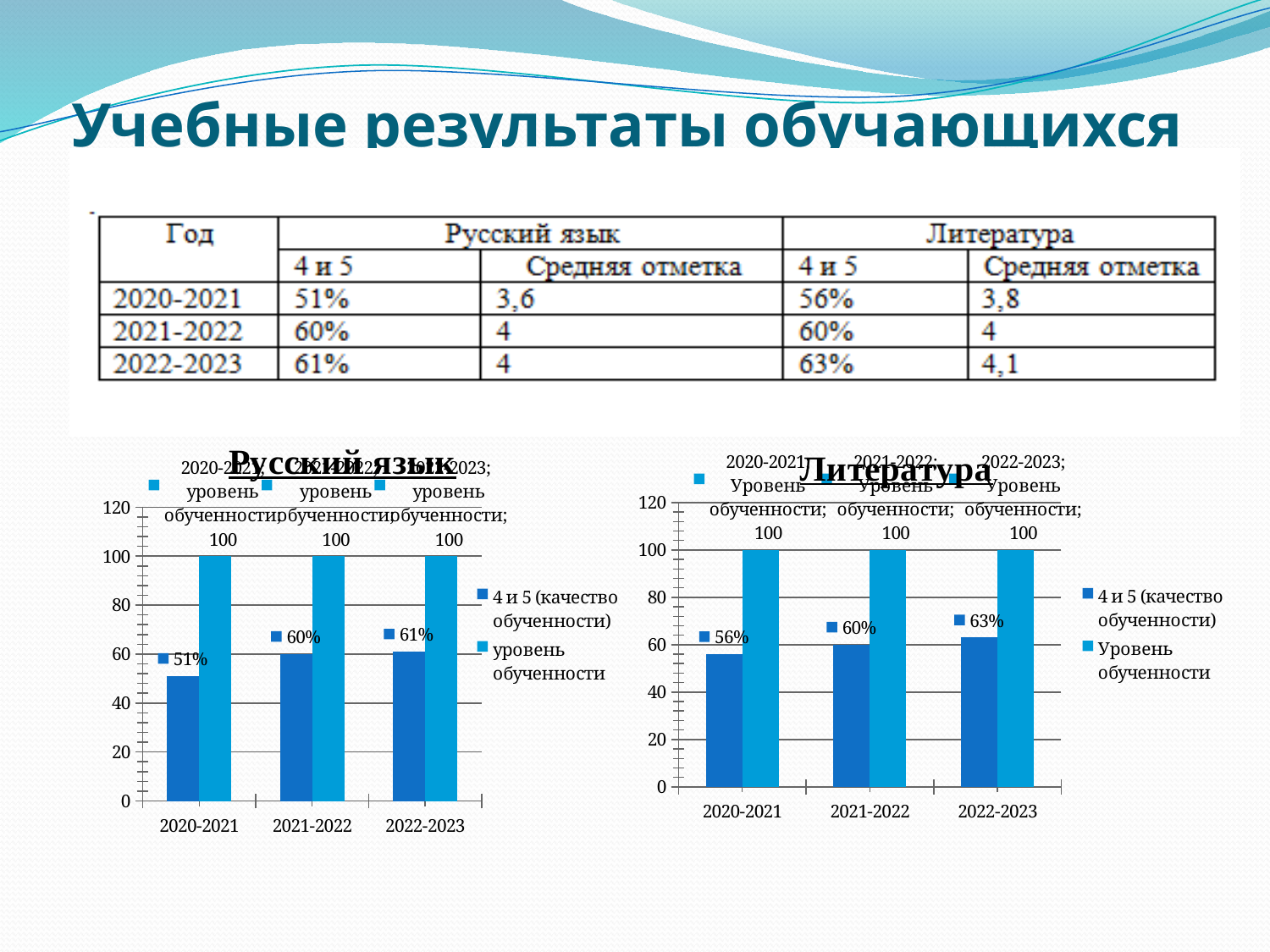
In the 'Русский язык' chart, what is the difference between the '4 и 5 (качество обученности)' values for 2021-2022 and 2020-2021? 9% In the 'Литература' chart, what is the value of 'Уровень обученности' for 2021-2022? 100 How many year categories are shown on the x axis of the 'Русский язык' chart? 3 In the 'Литература' chart, what is the value of '4 и 5 (качество обученности)' for 2020-2021? 56% In the 'Литература' chart, which year has the highest value for '4 и 5 (качество обученности)'? 2022-2023 In the 'Литература' chart, is the '4 и 5 (качество обученности)' value for 2020-2021 larger or smaller than the value for 2022-2023? smaller In the 'Русский язык' chart, what is the value of '4 и 5 (качество обученности)' for 2020-2021? 51% In the 'Русский язык' chart, which year has the lowest value for '4 и 5 (качество обученности)'? 2020-2021 In the 'Литература' chart, what is the value of '4 и 5 (качество обученности)' for 2022-2023? 63% In the 'Русский язык' chart, what is the value of '4 и 5 (качество обученности)' for 2022-2023? 61% What type of chart is the 'Русский язык' chart? bar chart How many series does the legend of the 'Литература' chart list? 2